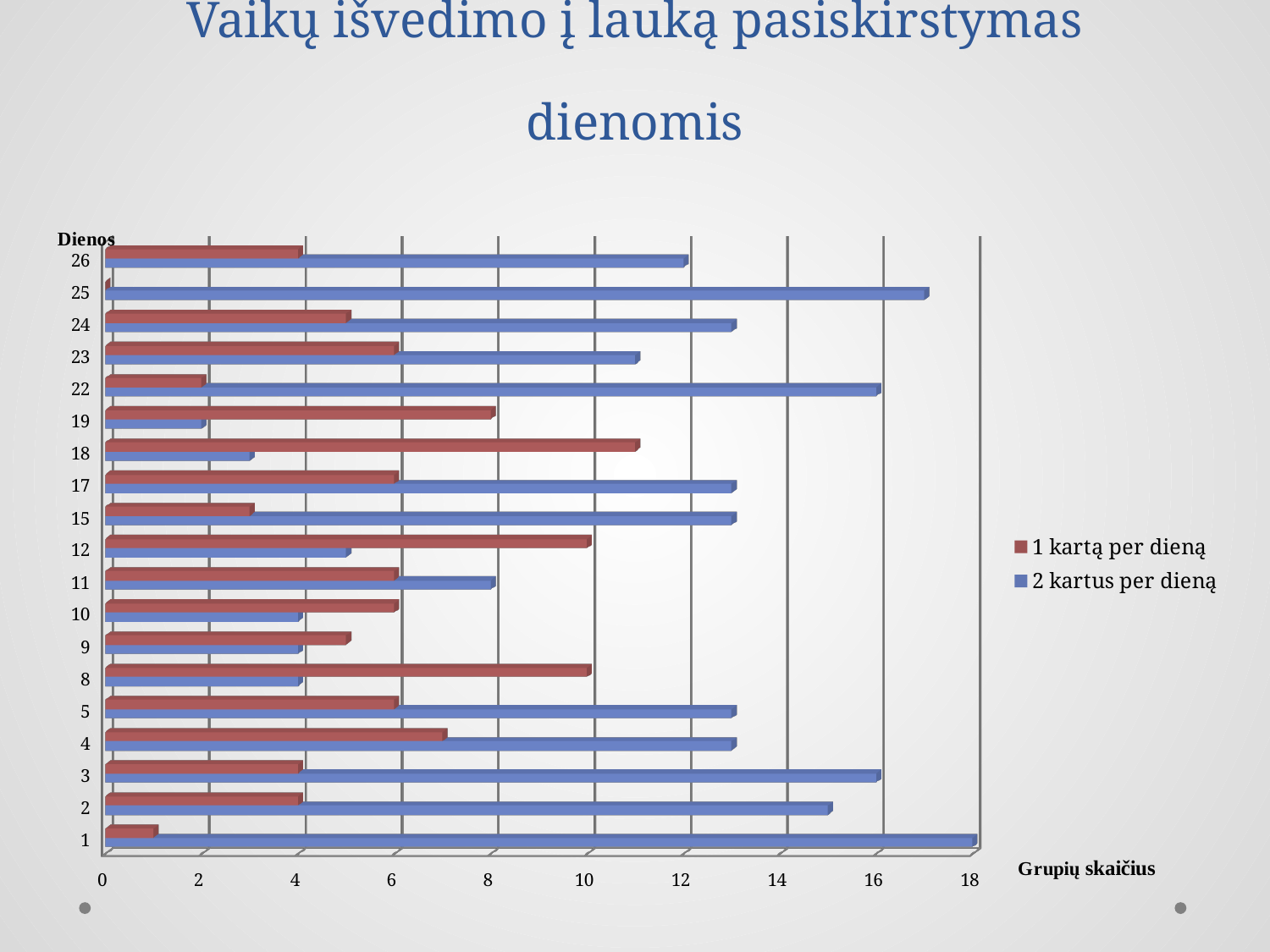
What is the value of '2 kartus per dieną' for day 26? 12 What kind of chart is shown on the slide? bar chart Which day has the lowest value for '2 kartus per dieną'? 19 How many days (categories) are shown on the vertical axis? 19 What is the difference between '2 kartus per dieną' and '1 kartą per dieną' for day 26? 8 Is the value of '2 kartus per dieną' for day 25 greater or less than 16? greater What is the value of '1 kartą per dieną' for day 12? 10 What is the value of '2 kartus per dieną' for day 1? 18 What is the value of '1 kartą per dieną' for day 19? 8 Which day has the highest value for '2 kartus per dieną'? 1 For day 18, which series has the larger value? 1 kartą per dieną How many series does the legend list? 2